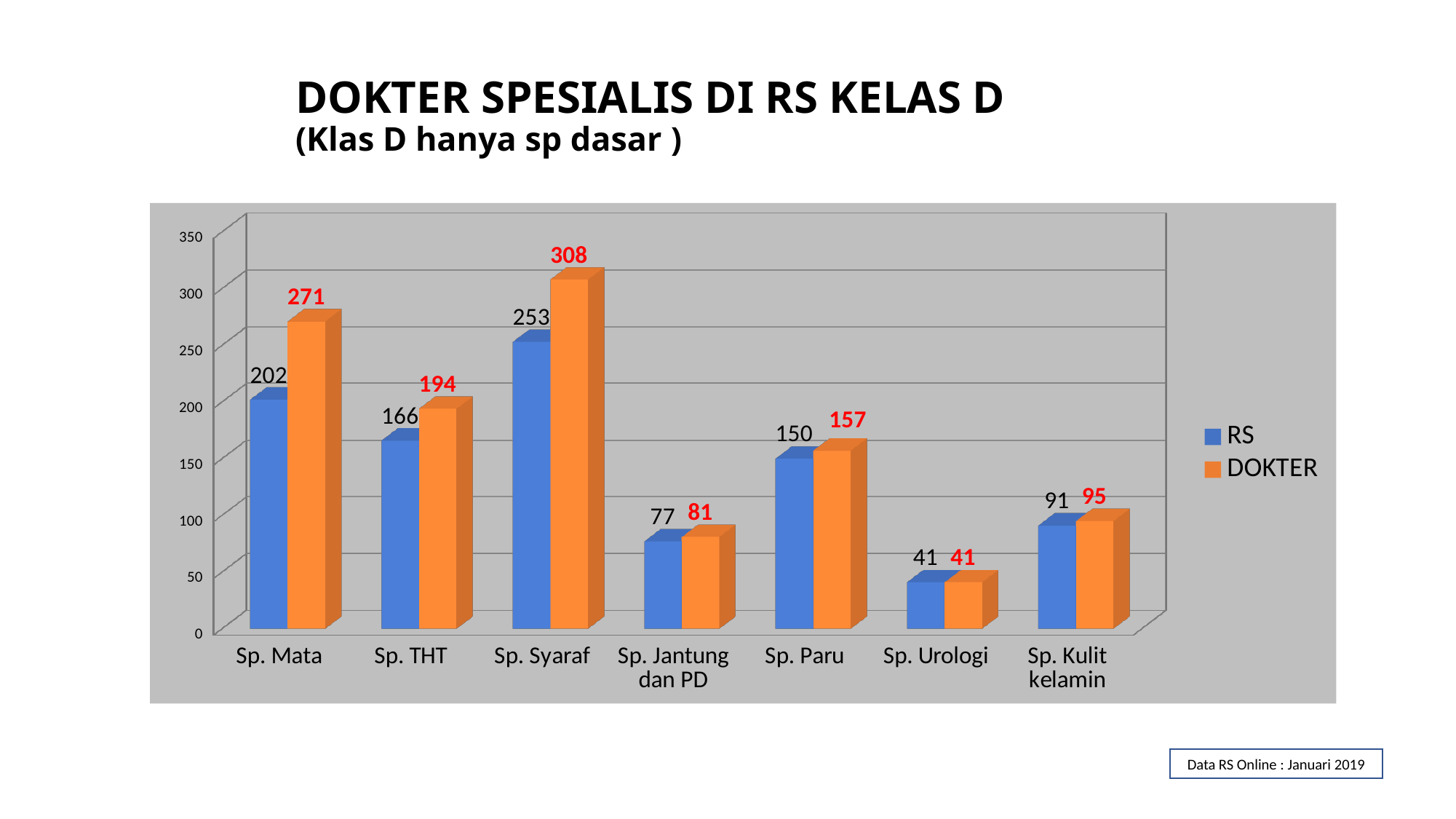
What is the RS value for Sp. Mata? 202 What kind of chart is shown on the slide? bar chart What is the difference between the DOKTER and RS values for Sp. Mata? 69 Is the RS value for Sp. Syaraf greater or less than 250? greater How many categories are shown on the x axis? 7 Which category has the lowest RS value? Sp. Urologi Which is larger for Sp. THT, the RS value or the DOKTER value? DOKTER How many series does the legend list? 2 What is the DOKTER value for Sp. Paru? 157 What are the two series named in the legend? RS and DOKTER Which category has the highest DOKTER value? Sp. Syaraf What is the DOKTER value for Sp. Syaraf? 308